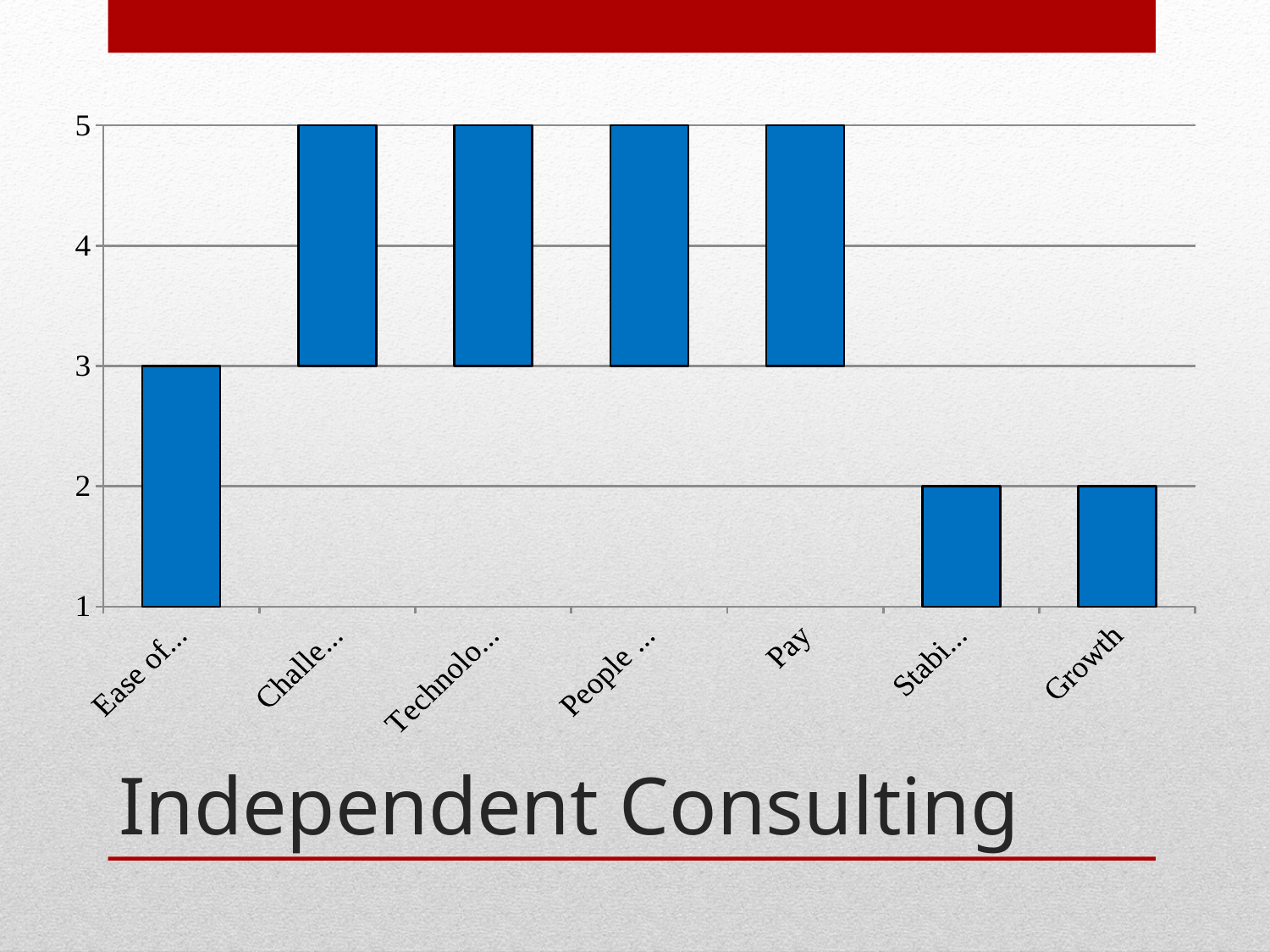
How many bars reach the value 5? 4 Is the value for Growth greater or less than 3? less Which is larger, the value for Pay or the value for Growth? Pay How many categories (bars) does the chart have? 7 What kind of chart is shown on the slide? bar chart What colour are the bars in the chart? blue What is the title shown on the slide below the chart? Independent Consulting What is the value for Pay? 3 to 5 What is the value of the first (leftmost) bar? 3 What is the value for Growth? 2